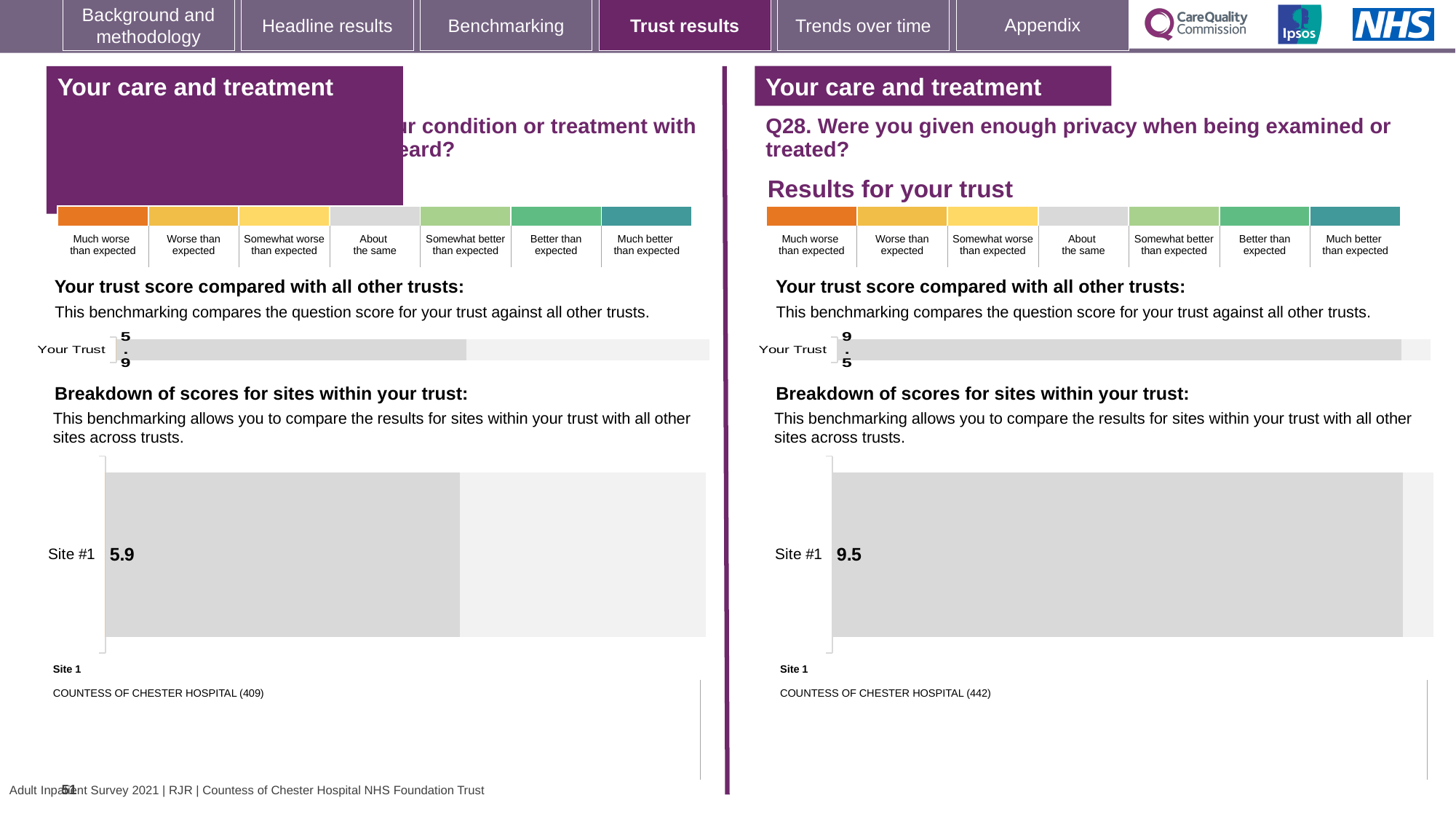
On the left-hand breakdown chart, which hospital is listed as Site 1? COUNTESS OF CHESTER HOSPITAL (409) Is the Your Trust score on the left-hand 'Your trust score compared with all other trusts' chart greater or less than the Your Trust score on the right-hand Q28 chart? less Which is larger: the Site #1 score on the left-hand breakdown chart or the Site #1 score on the right-hand breakdown chart for Q28? The right-hand (Q28) Site #1 score On the left-hand 'Breakdown of scores for sites within your trust' chart, what is the score for Site #1? 5.9 On the left-hand 'Your trust score compared with all other trusts' chart, what is the score shown for Your Trust? 5.9 On the right-hand Q28 breakdown chart, which hospital is listed as Site 1? COUNTESS OF CHESTER HOSPITAL (442) What is the difference between the Site #1 score on the right-hand Q28 breakdown chart and the Site #1 score on the left-hand breakdown chart? 3.6 How many sites are shown on the right-hand 'Breakdown of scores for sites within your trust' chart for Q28? 1 What kind of chart is used for the 'Breakdown of scores for sites within your trust' on the right-hand side of the slide? Bar chart How many sites are shown on the left-hand 'Breakdown of scores for sites within your trust' chart? 1 On the right-hand 'Breakdown of scores for sites within your trust' chart for Q28, what is the score for Site #1? 9.5 On the right-hand chart for Q28 (privacy when being examined or treated), what is the score shown for Your Trust? 9.5